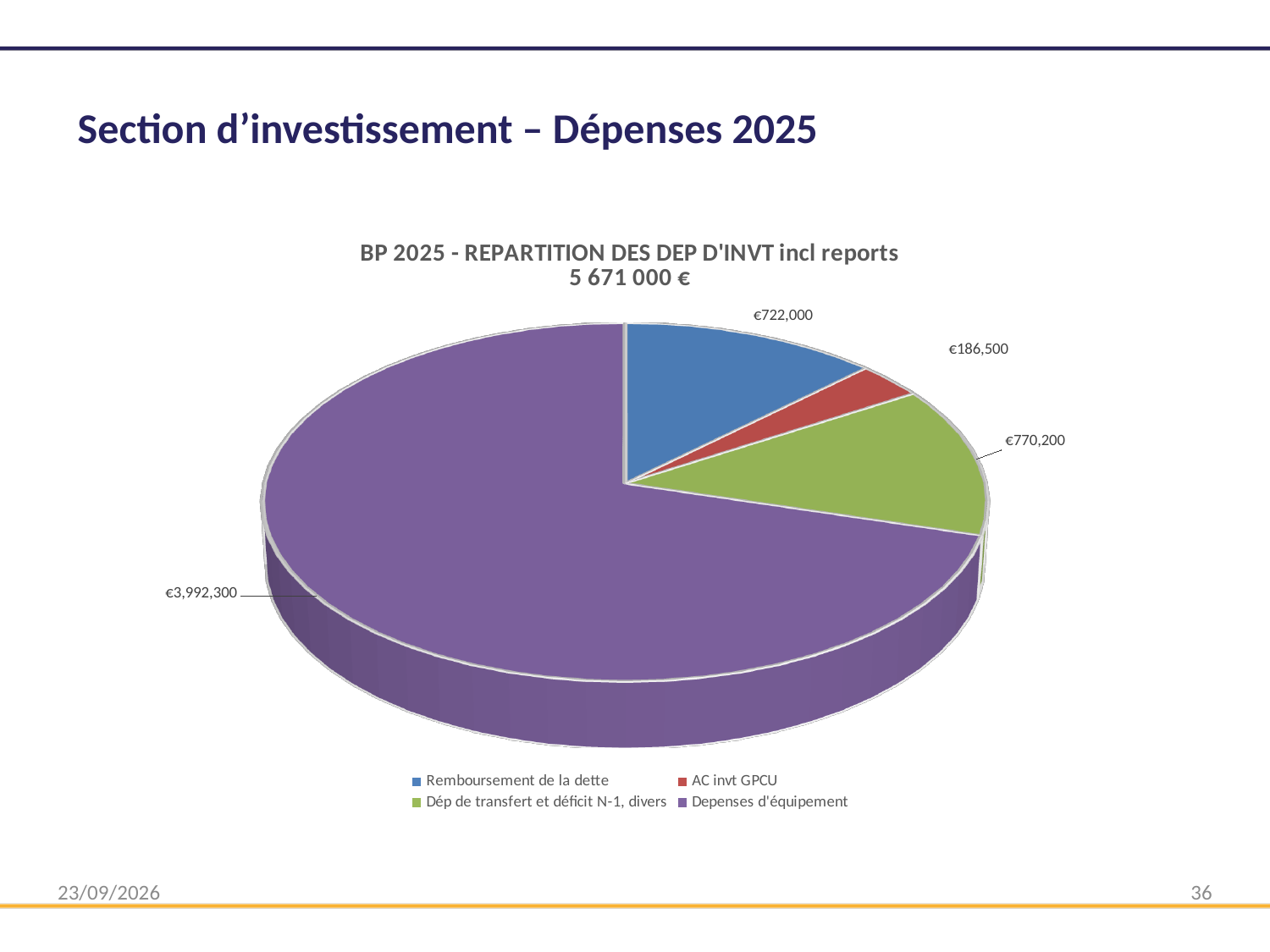
What is the value for Remboursement de la dette? €722,000 What is the difference between Depenses d'équipement and Dép de transfert et déficit N-1, divers? €3,222,100 What is the value for Depenses d'équipement? €3,992,300 How many categories does the legend list? 4 What is the value for AC invt GPCU? €186,500 Which category has the smallest slice of the pie? AC invt GPCU What is the value for Dép de transfert et déficit N-1, divers? €770,200 What is the difference between Remboursement de la dette and AC invt GPCU? €535,500 What type of chart is shown on the slide? Pie chart Which is larger, Dép de transfert et déficit N-1, divers or Remboursement de la dette? Dép de transfert et déficit N-1, divers Which category has the largest slice of the pie? Depenses d'équipement What total amount is stated in the chart title? 5 671 000 €